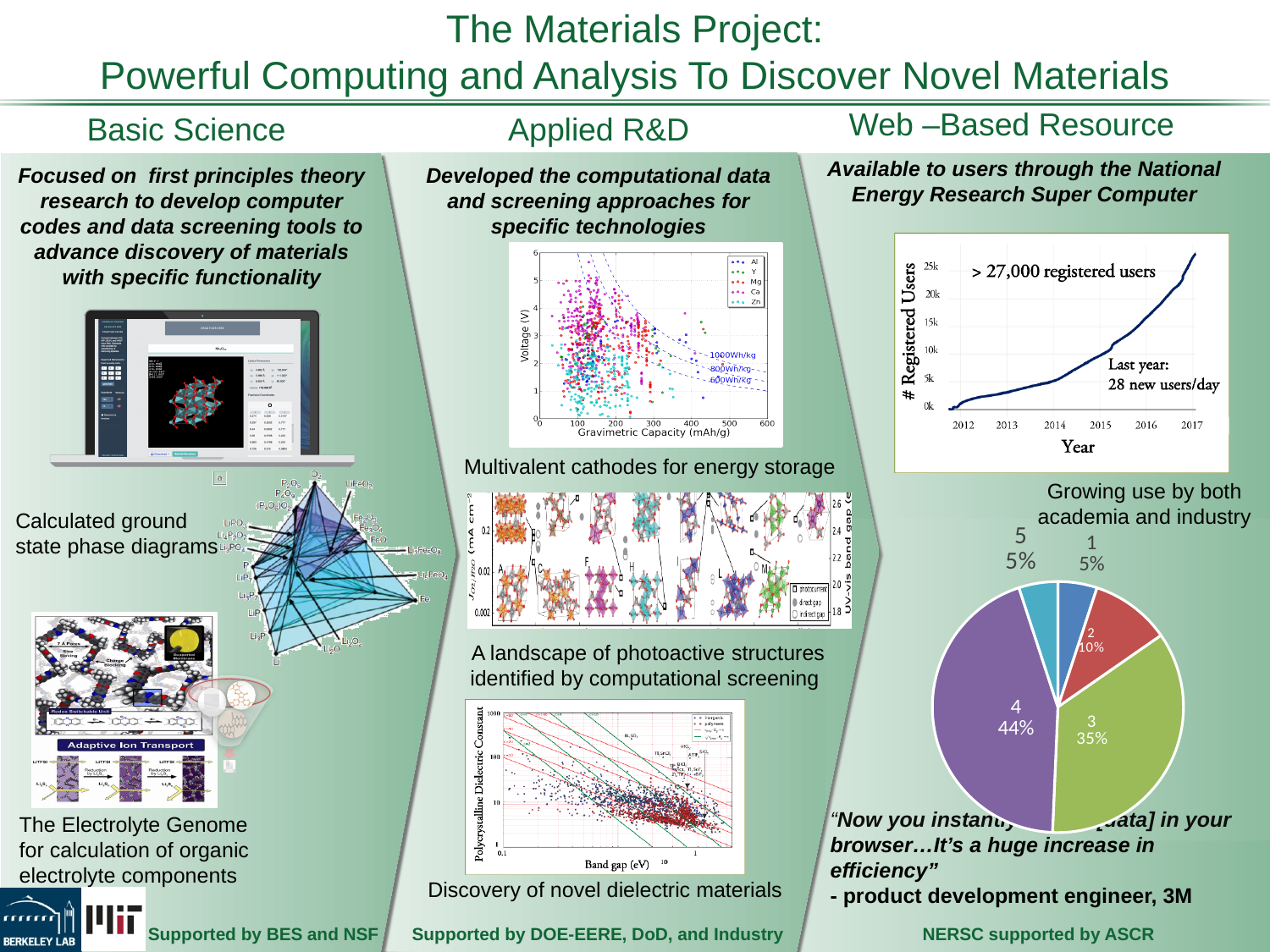
What kind of chart is the 'Multivalent cathodes for energy storage' chart of Voltage versus Gravimetric Capacity? scatter plot In the pie chart under 'Growing use by both academia and industry', which is larger, slice 2 or slice 3? 3 In the pie chart under 'Growing use by both academia and industry', how many slices are there? 5 In the '# Registered Users' chart, is the number of registered users at the end of 2017 greater or less than 25k? greater In the pie chart under 'Growing use by both academia and industry', which slice is the largest? 4 In the 'Multivalent cathodes for energy storage' chart, how many series does the legend list? 5 In the pie chart under 'Growing use by both academia and industry', what is the combined share of slices 1 and 5? 10% In the pie chart under 'Growing use by both academia and industry', what is the difference in percentage points between slice 4 and slice 3? 9 In the pie chart under 'Growing use by both academia and industry', what percentage does slice 3 represent? 35% In the '# Registered Users' chart in the Web-Based Resource column, do the values rise or fall from 2012 to 2017? rise In the '# Registered Users' chart, is the number of registered users in 2014 greater or less than 10k? less In the pie chart under 'Growing use by both academia and industry', what percentage does slice 4 represent? 44%